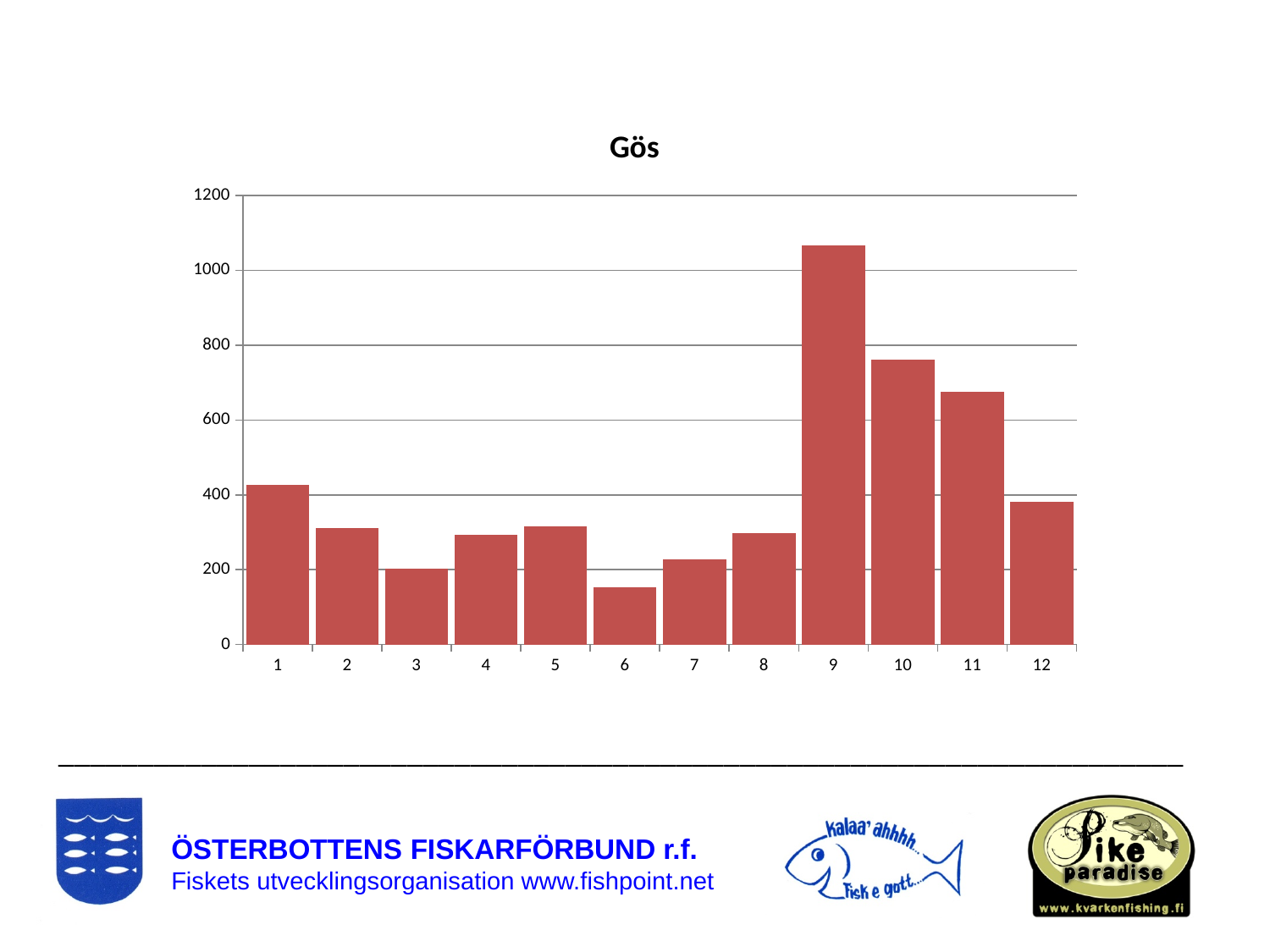
What is the title of the chart? Gös Is the value for category 10 greater or less than 800? less Which has the larger value, category 1 or category 2? 1 Is the value for category 6 greater or less than 200? less Is the value for category 1 greater or less than 400? greater Which category has the highest value in the chart? 9 What kind of chart is shown on the slide? bar chart Which category has the lowest value in the chart? 6 Which has the larger value, category 10 or category 11? 10 How many categories are shown on the x axis of the chart? 12